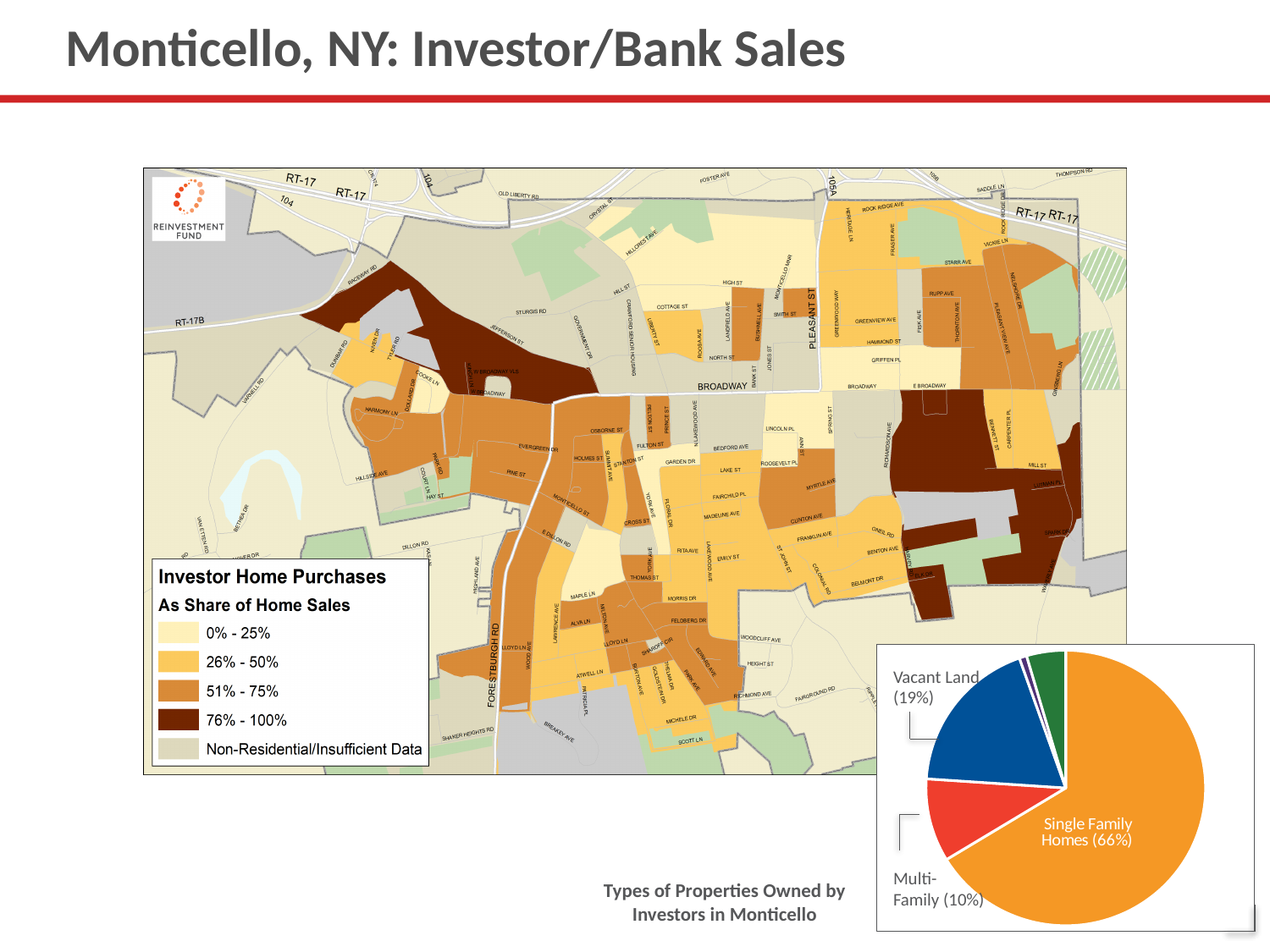
In the pie chart 'Types of Properties Owned by Investors in Monticello', what share is Single Family Homes? 66% In the pie chart 'Types of Properties Owned by Investors in Monticello', how many percentage points larger is Vacant Land than Multi-Family? 9 In the pie chart 'Types of Properties Owned by Investors in Monticello', how many slices have a printed label with a percentage? 3 In the pie chart 'Types of Properties Owned by Investors in Monticello', what colour is the Single Family Homes slice? Orange In the pie chart 'Types of Properties Owned by Investors in Monticello', how many percentage points larger is Single Family Homes than Vacant Land? 47 In the pie chart 'Types of Properties Owned by Investors in Monticello', which labeled property type has the smallest share? Multi-Family What is the title of the pie chart on the slide? Types of Properties Owned by Investors in Monticello In the pie chart 'Types of Properties Owned by Investors in Monticello', what share is Multi-Family? 10% In the pie chart 'Types of Properties Owned by Investors in Monticello', which is larger: Vacant Land or Multi-Family? Vacant Land What kind of chart is 'Types of Properties Owned by Investors in Monticello'? Pie chart In the pie chart 'Types of Properties Owned by Investors in Monticello', what share is Vacant Land? 19% In the pie chart 'Types of Properties Owned by Investors in Monticello', which labeled property type has the largest share? Single Family Homes